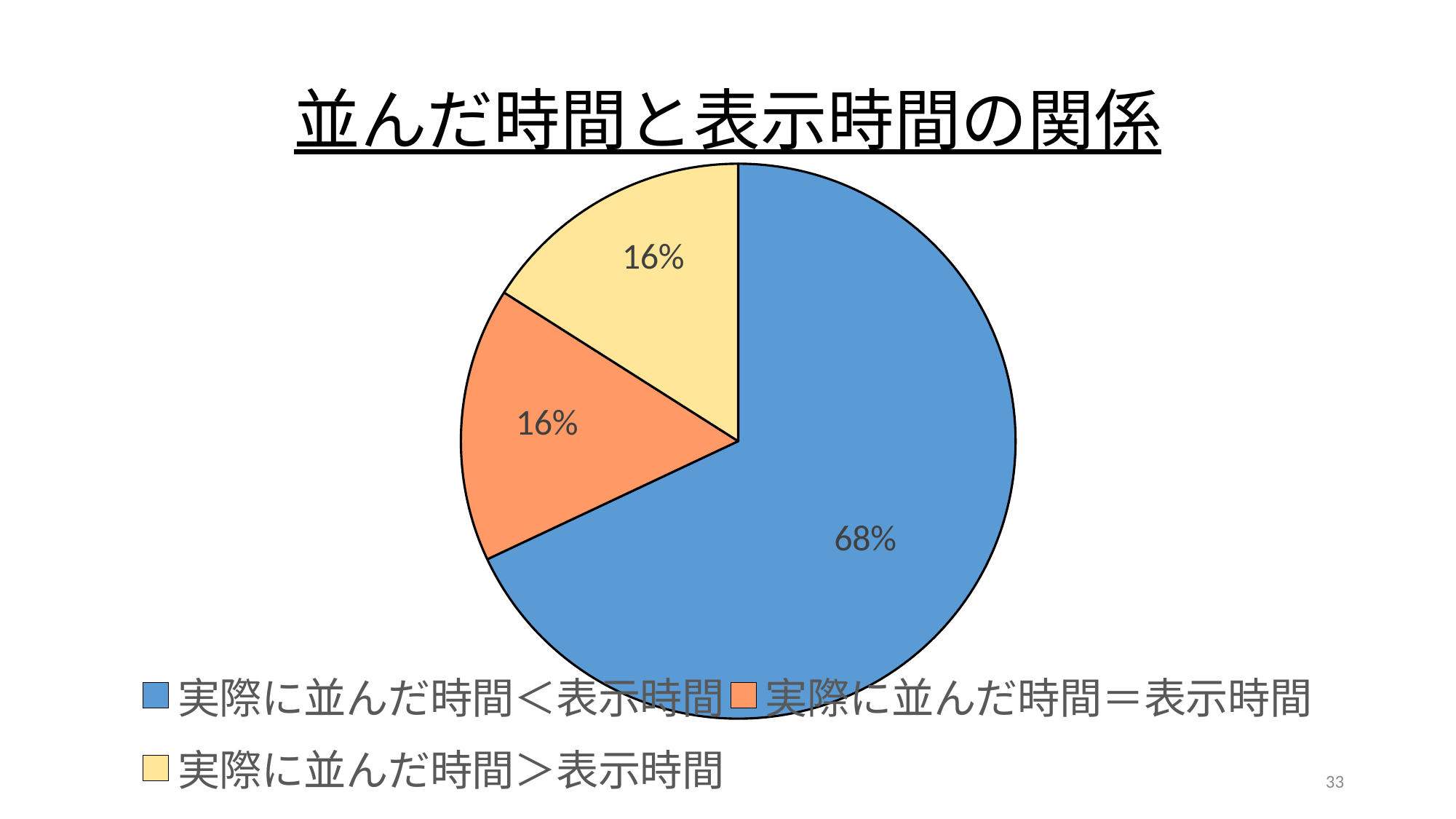
What colour is the slice for 実際に並んだ時間＝表示時間? orange What share of the pie is labelled 実際に並んだ時間＞表示時間? 16% What is the difference in percentage points between the 実際に並んだ時間＜表示時間 slice and the 実際に並んだ時間＝表示時間 slice? 52 Which category has the largest slice of the pie? 実際に並んだ時間＜表示時間 Which is larger, the slice for 実際に並んだ時間＜表示時間 or the slice for 実際に並んだ時間＞表示時間? 実際に並んだ時間＜表示時間 What is the title of the chart? 並んだ時間と表示時間の関係 What share of the pie is labelled 実際に並んだ時間＝表示時間? 16% What share of the pie is labelled 実際に並んだ時間＜表示時間? 68% What kind of chart is shown on the slide? pie chart Is the share for 実際に並んだ時間＜表示時間 greater or less than 50%? greater How many entries does the legend list? 3 How many slices does the pie chart have? 3